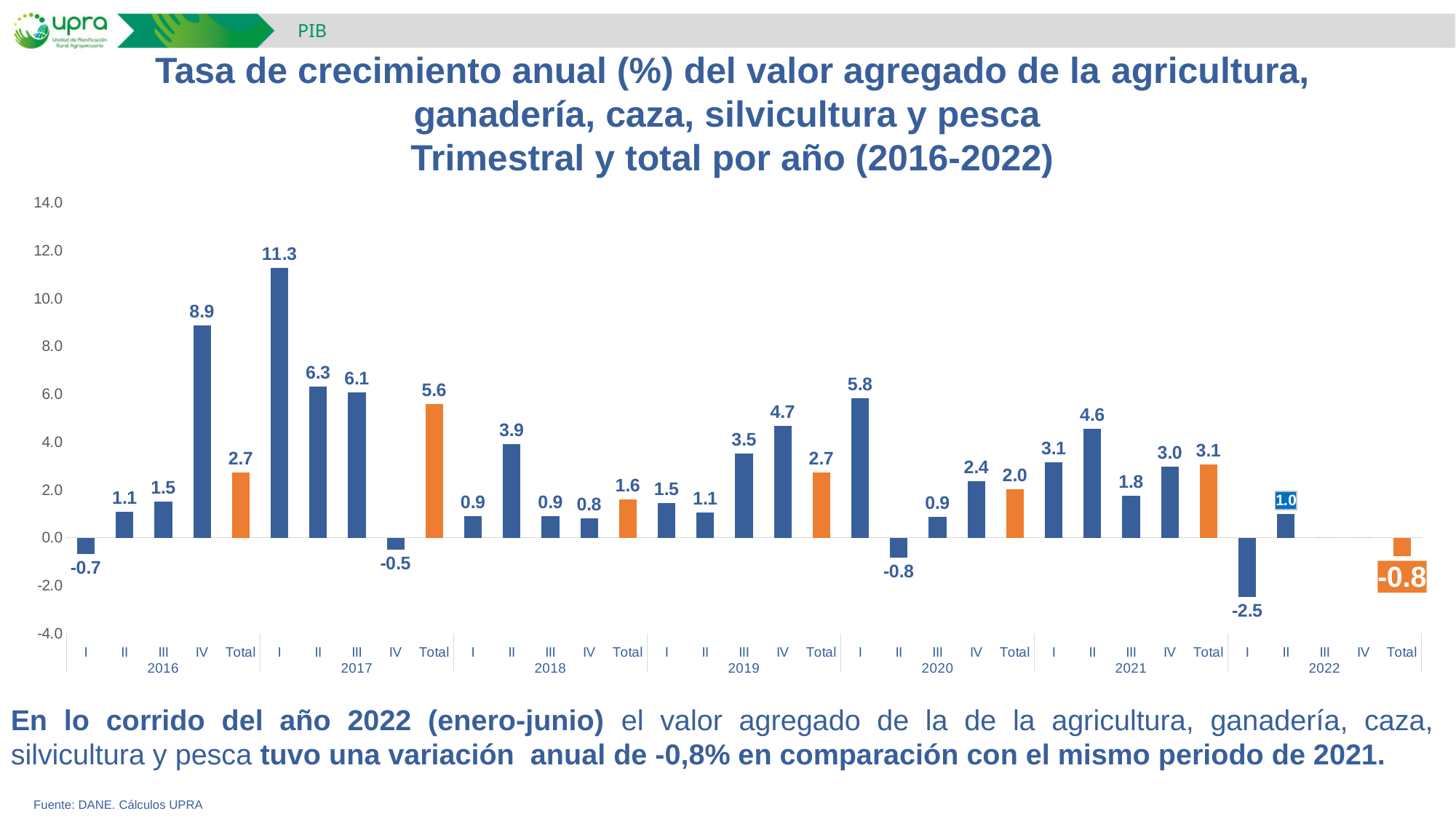
What is the value for the fourth quarter (IV) of 2016? 8.9 What is the difference between the Total for 2017 and the Total for 2018? 4.0 What is the value of the Total bar for 2021? 3.1 What colour are the annual Total bars in the chart? Orange What is the annual growth rate shown for the first quarter (I) of 2017? 11.3 Is the value for quarter I of 2020 greater or less than 4.0? greater What kind of chart is shown on the slide? Bar chart Which quarter has the lowest growth rate in the chart? I 2022 How many annual Total bars are shown in the chart? 7 What is the value shown for the Total bar of 2022? -0.8 Which is larger, the value for quarter II of 2021 or the value for quarter IV of 2019? IV 2019 Which quarter has the highest growth rate in the chart? I 2017